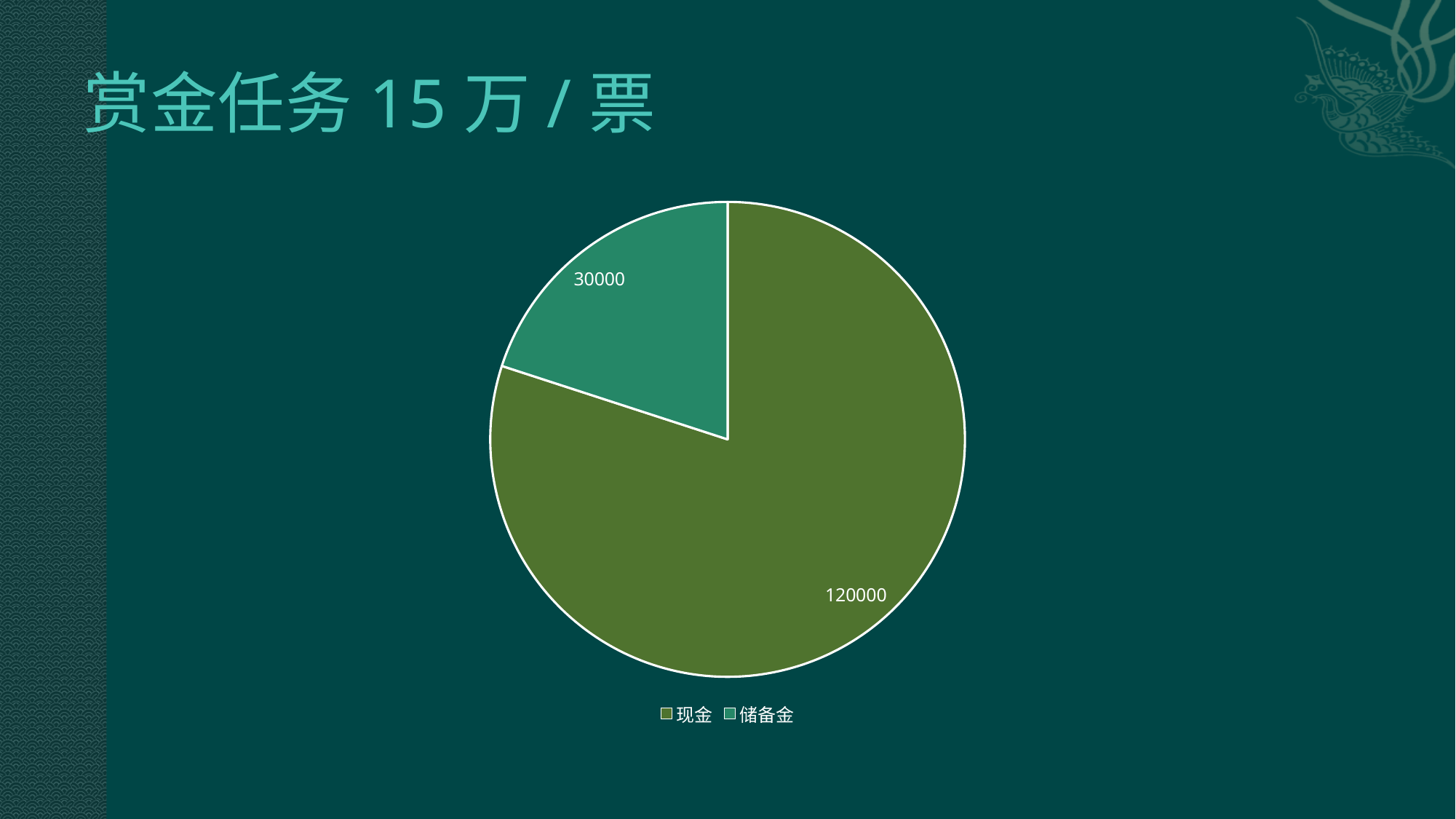
What is the difference between the 现金 value and the 储备金 value? 90000 Which category has the largest slice in the pie chart? 现金 Which is larger, 现金 or 储备金? 现金 What is the total of all slices in the pie chart? 150000 What kind of chart is shown on the slide? Pie chart What share of the pie does the 储备金 slice represent? 20% What is the value of the 现金 slice in the pie chart? 120000 How many entries does the legend list? 2 What share of the pie does the 现金 slice represent? 80% How many slices does the pie chart have? 2 Which category has the smallest slice in the pie chart? 储备金 What is the value of the 储备金 slice in the pie chart? 30000